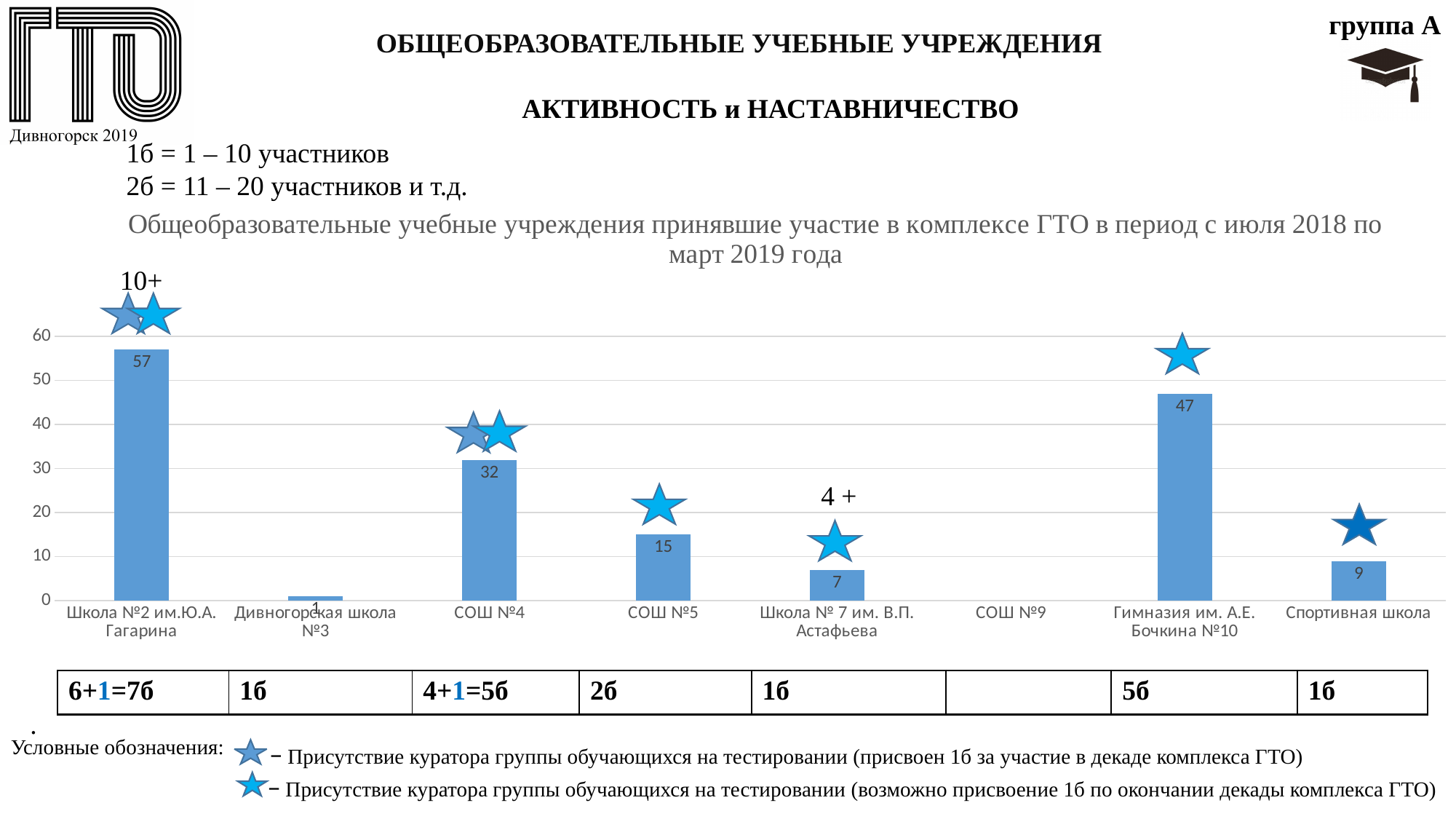
What value is shown for Спортивная школа? 9 Is the value for Школа № 7 им. В.П. Астафьева greater or less than 10? less What value is shown for Гимназия им. А.Е. Бочкина №10? 47 What is the title of the chart? Общеобразовательные учебные учреждения принявшие участие в комплексе ГТО в период с июля 2018 по март 2019 года What kind of chart is shown on the slide? bar chart Which is larger, the value for СОШ №4 or the value for Гимназия им. А.Е. Бочкина №10? Гимназия им. А.Е. Бочкина №10 What value is shown for Школа №2 им.Ю.А. Гагарина? 57 Which category has the highest value? Школа №2 им.Ю.А. Гагарина What value is shown for СОШ №5? 15 What is the difference between the values for СОШ №4 and СОШ №5? 17 How many categories are shown on the x axis of the chart? 8 What is the difference between the values for Школа №2 им.Ю.А. Гагарина and Гимназия им. А.Е. Бочкина №10? 10